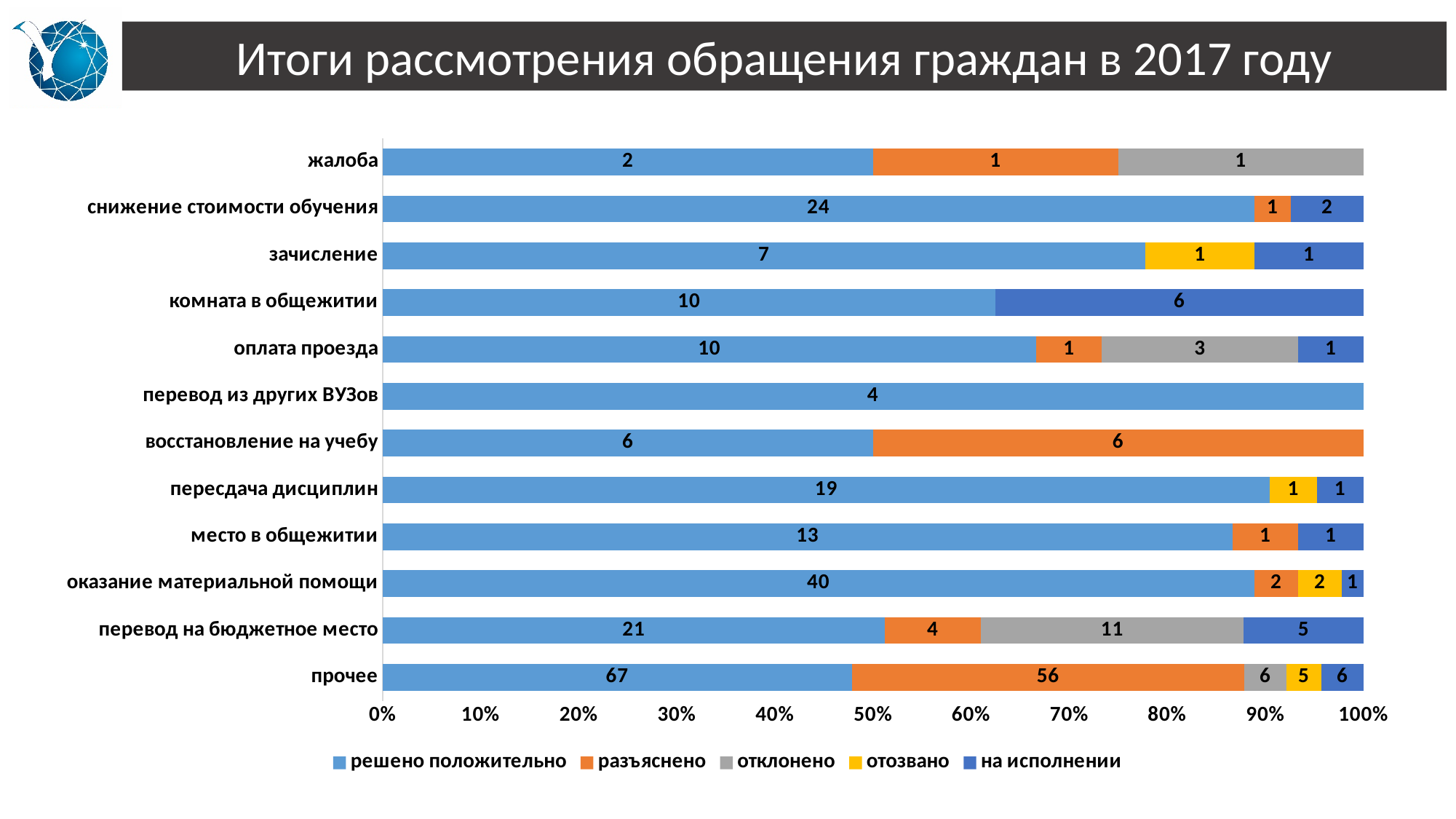
What is the total of the stacked bar for 'прочее'? 140 Which is larger: 'на исполнении' for 'комната в общежитии' or 'на исполнении' for 'перевод на бюджетное место'? комната в общежитии How many series does the legend list? 5 What is the value of 'решено положительно' for 'оказание материальной помощи'? 40 Which category has the lowest value for 'решено положительно'? жалоба What is the value of 'разъяснено' for 'прочее'? 56 What is the difference between 'решено положительно' and 'разъяснено' for 'прочее'? 11 What type of chart is shown on the slide? stacked bar chart How many categories are shown on the chart? 12 Which category has the highest value for 'решено положительно'? прочее What is the title of the chart on the slide? Итоги рассмотрения обращения граждан в 2017 году What is the value of 'отклонено' for 'перевод на бюджетное место'? 11